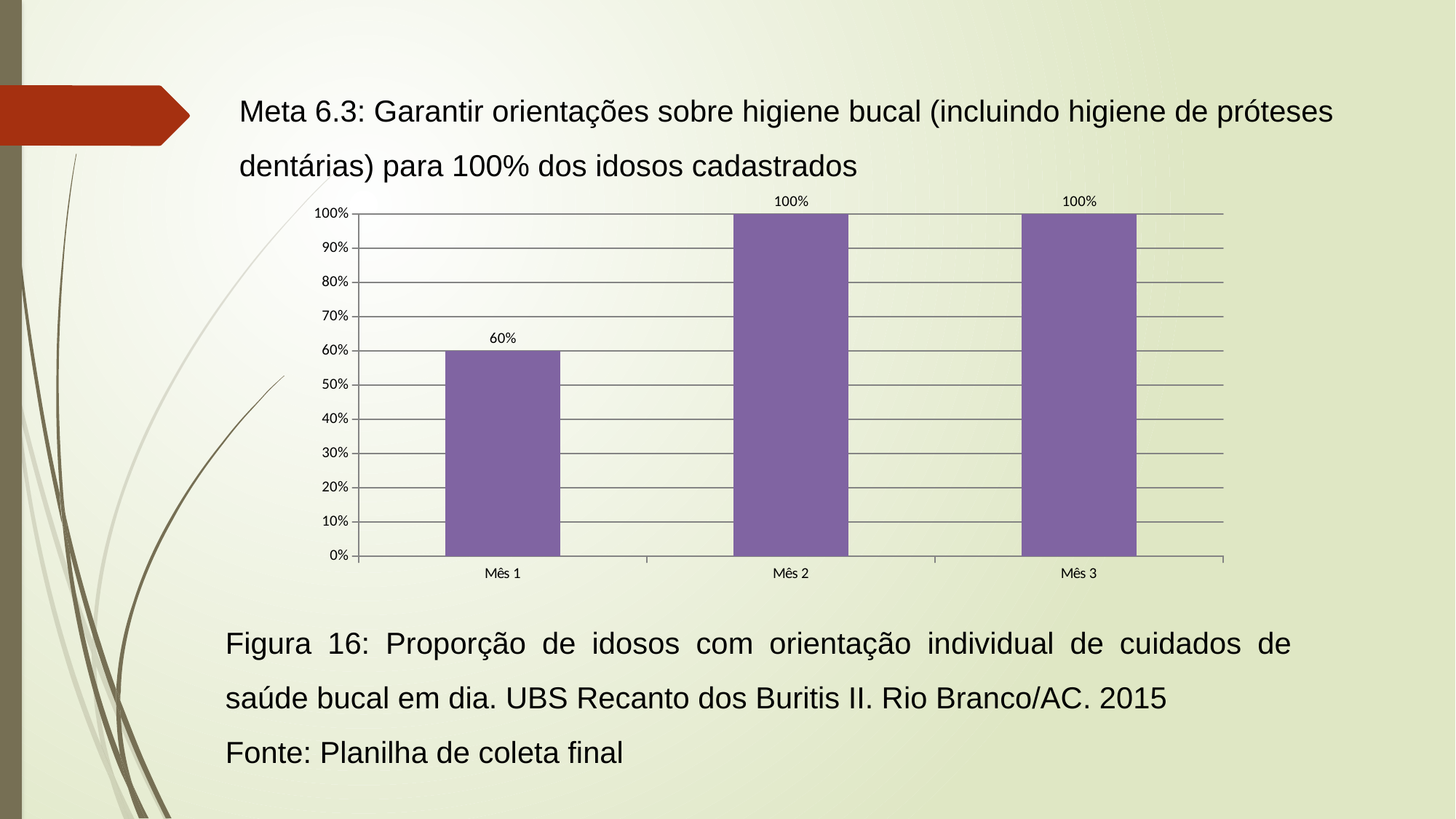
Do the values rise or fall from Mês 1 to Mês 2? rise What colour are the bars in the chart? purple Which is larger, the value for Mês 1 or the value for Mês 3? Mês 3 What is the value for Mês 1? 60% Which month has the lowest value? Mês 1 What kind of chart is shown on the slide? bar chart What is the value for Mês 3? 100% What is the highest value shown on the y axis? 100% What is the difference between the values for Mês 2 and Mês 1? 40% Is the value for Mês 1 greater or less than 70%? less What is the value for Mês 2? 100% How many months are shown on the x axis? 3